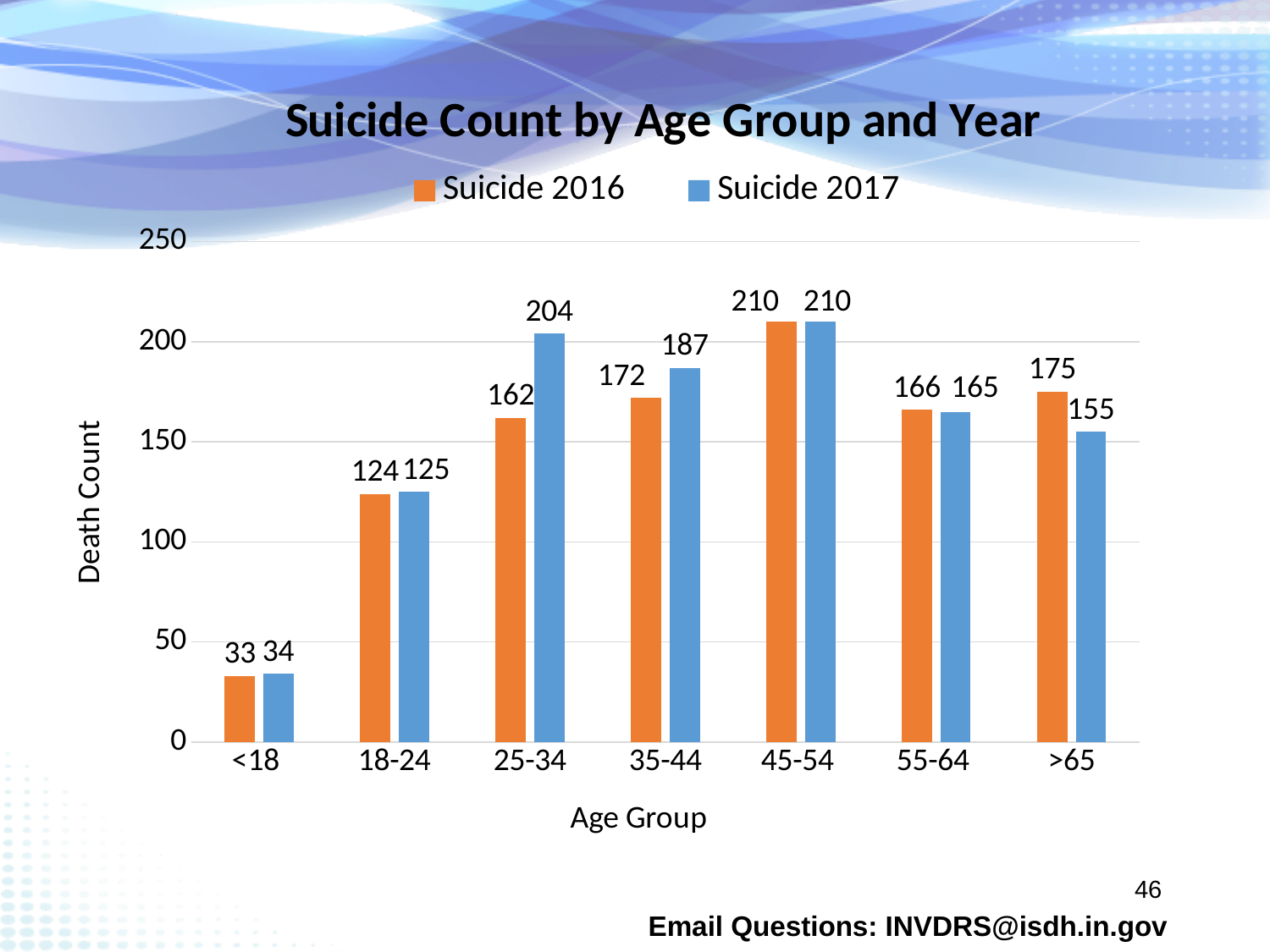
How many series does the legend list? 2 Which age group has the highest Suicide 2017 death count? 45-54 What is the Suicide 2016 death count for the >65 age group? 175 What is the difference between the Suicide 2017 and Suicide 2016 death counts for the 25-34 age group? 42 Which age group has the lowest Suicide 2016 death count? <18 What is the title of the chart? Suicide Count by Age Group and Year What is the Suicide 2016 death count for the <18 age group? 33 What is the Suicide 2017 death count for the 25-34 age group? 204 For the >65 age group, which is larger: the Suicide 2016 count or the Suicide 2017 count? Suicide 2016 How many age groups are shown on the x axis? 7 What is the label of the y axis? Death Count What kind of chart is shown on the slide? Bar chart